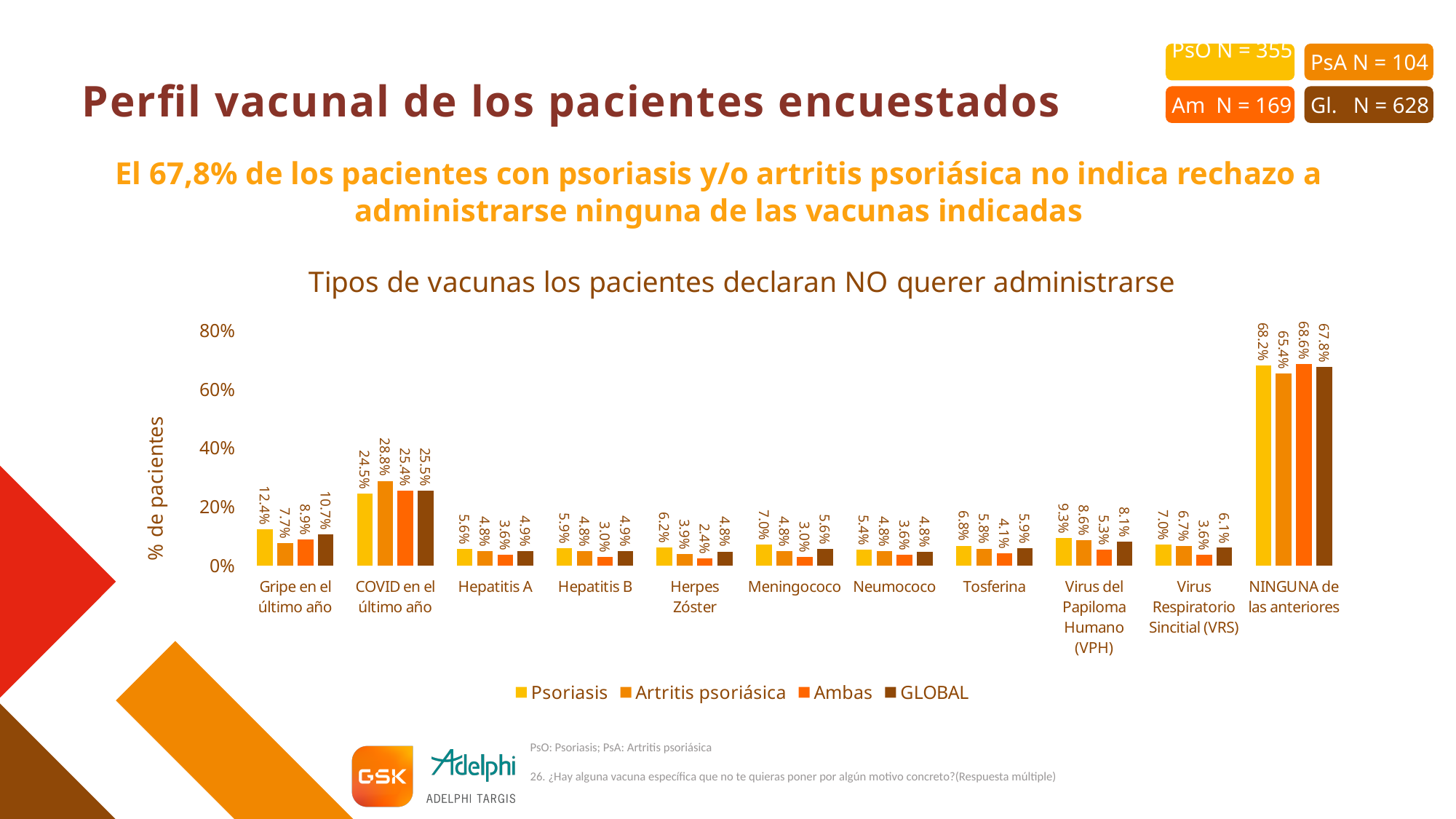
What is the title of the chart? Tipos de vacunas los pacientes declaran NO querer administrarse Is the GLOBAL value for 'COVID en el último año' greater or less than 20%? greater What is the difference between the Psoriasis and Artritis psoriásica values for 'Gripe en el último año'? 4.7% What is the Artritis psoriásica value for 'COVID en el último año'? 28.8% How many vaccine categories are shown on the x axis? 11 What type of chart is shown on the slide? bar chart How many series does the legend list? 4 Which is larger for 'Virus del Papiloma Humano (VPH)': the Psoriasis value or the GLOBAL value? Psoriasis What is the GLOBAL value for 'NINGUNA de las anteriores'? 67.8% Which category has the lowest Ambas value? Herpes Zóster Which category has the highest Psoriasis value? NINGUNA de las anteriores What is the Ambas value for 'Herpes Zóster'? 2.4%